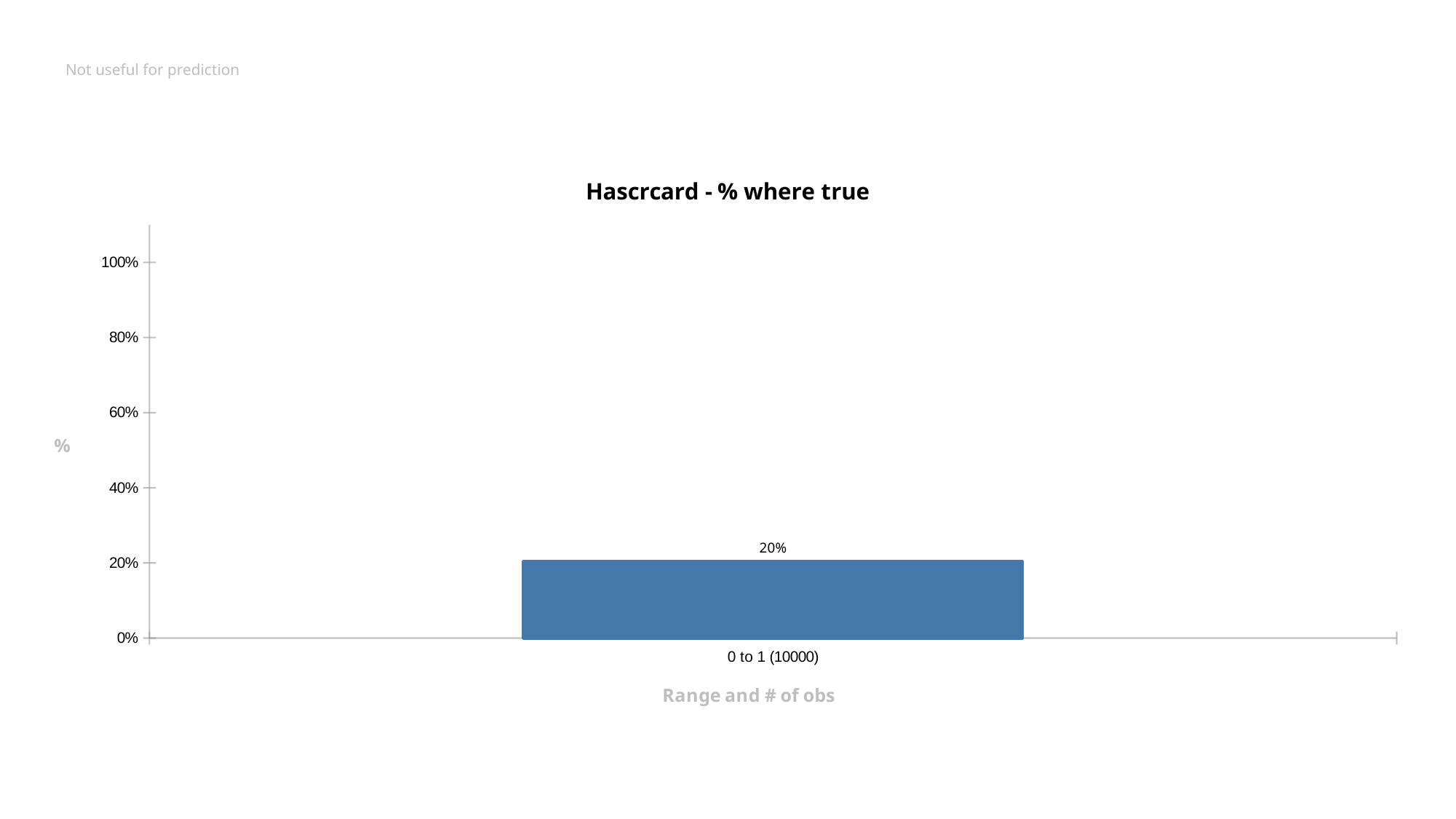
What is the title of the chart? Hascrcard - % where true What kind of chart is shown on the slide? bar chart How many bars are plotted in the chart? 1 What is the label of the only category on the x axis? 0 to 1 (10000) What is the value for the category "0 to 1 (10000)"? 20% Is the value for "0 to 1 (10000)" greater or less than 40%? less What is the highest value shown on the y axis of the chart? 100% What is the label on the x axis of the chart? Range and # of obs